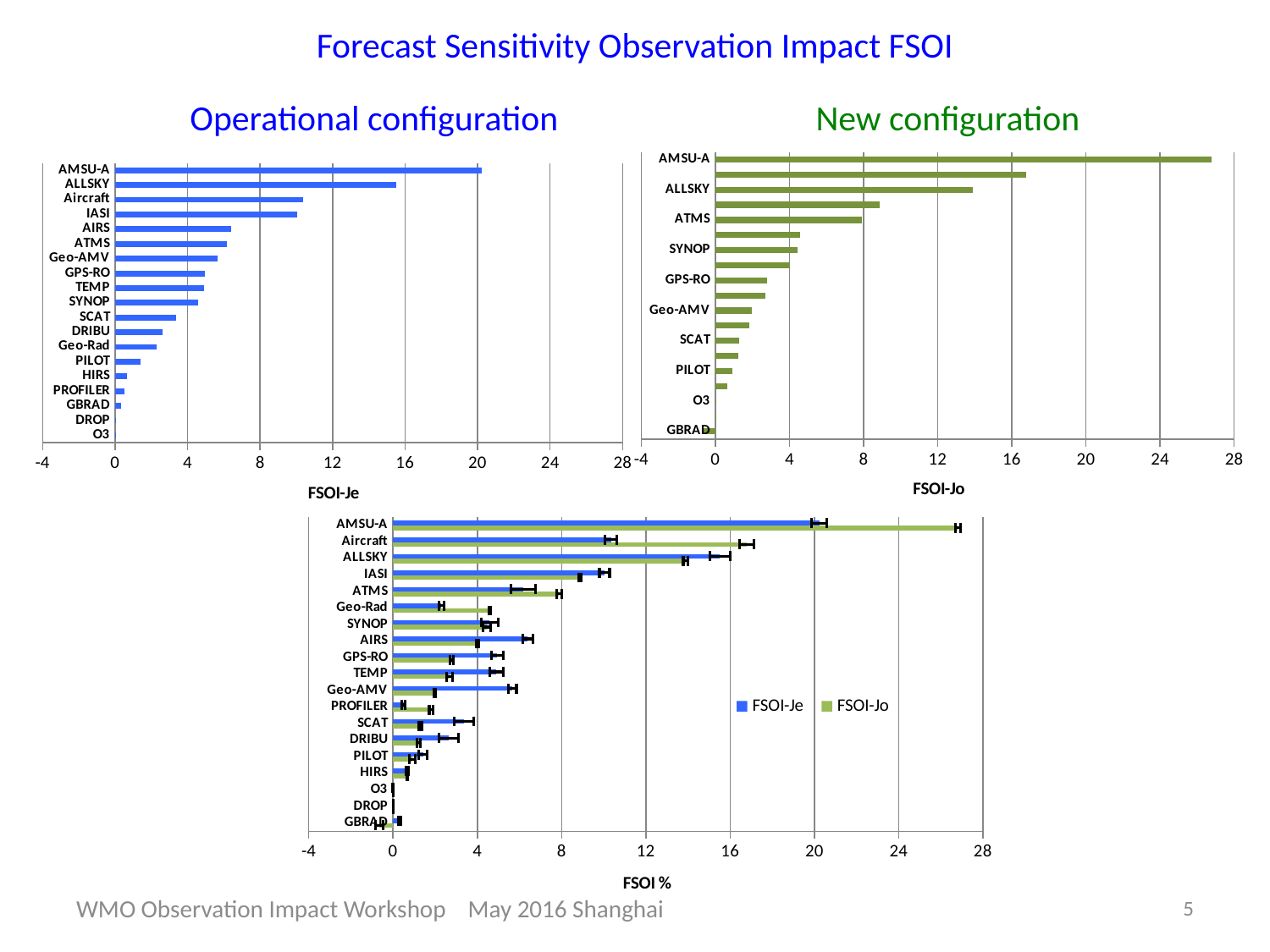
In the Operational configuration chart, which is larger, the value for AIRS or the value for SCAT? AIRS In the bottom chart (FSOI %), is the FSOI-Jo value for Aircraft greater or less than 12? greater In the bottom chart (FSOI %), which is larger for AMSU-A, FSOI-Je or FSOI-Jo? FSOI-Jo In the Operational configuration chart, is the value for Aircraft greater or less than 8? greater In the New configuration chart, is the value for AMSU-A greater or less than 24? greater How many categories are shown in the Operational configuration chart? 19 How many series does the legend of the bottom chart (FSOI %) list? 2 What kind of chart is the Operational configuration chart? bar chart In the Operational configuration chart, which category has the highest value? AMSU-A In the New configuration chart, which category has the highest value? AMSU-A